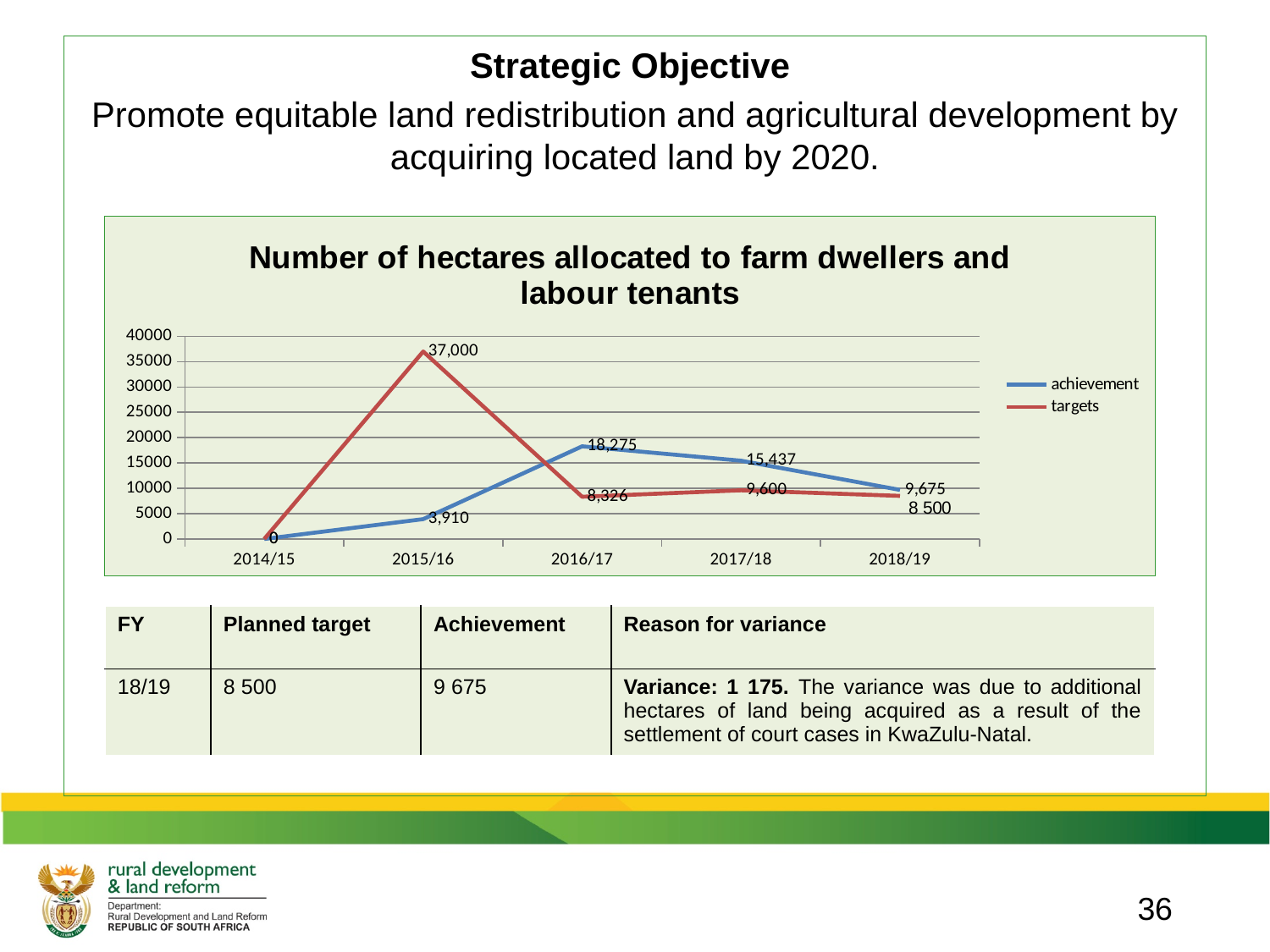
Does the achievement line rise or fall from 2016/17 to 2018/19? fall How many financial years are plotted on the x axis? 5 In 2016/17, which is larger: the achievement or the target? achievement What kind of chart is shown on the slide? line chart What is the targets value for 2015/16? 37,000 In which financial year is the targets value highest? 2015/16 How many series does the chart legend list? 2 What is the achievement value for 2016/17? 18,275 In which financial year is the achievement value highest? 2016/17 What is the achievement value for 2018/19? 9,675 What is the targets value for 2017/18? 9,600 By how much does the achievement exceed the target in 2018/19? 1,175